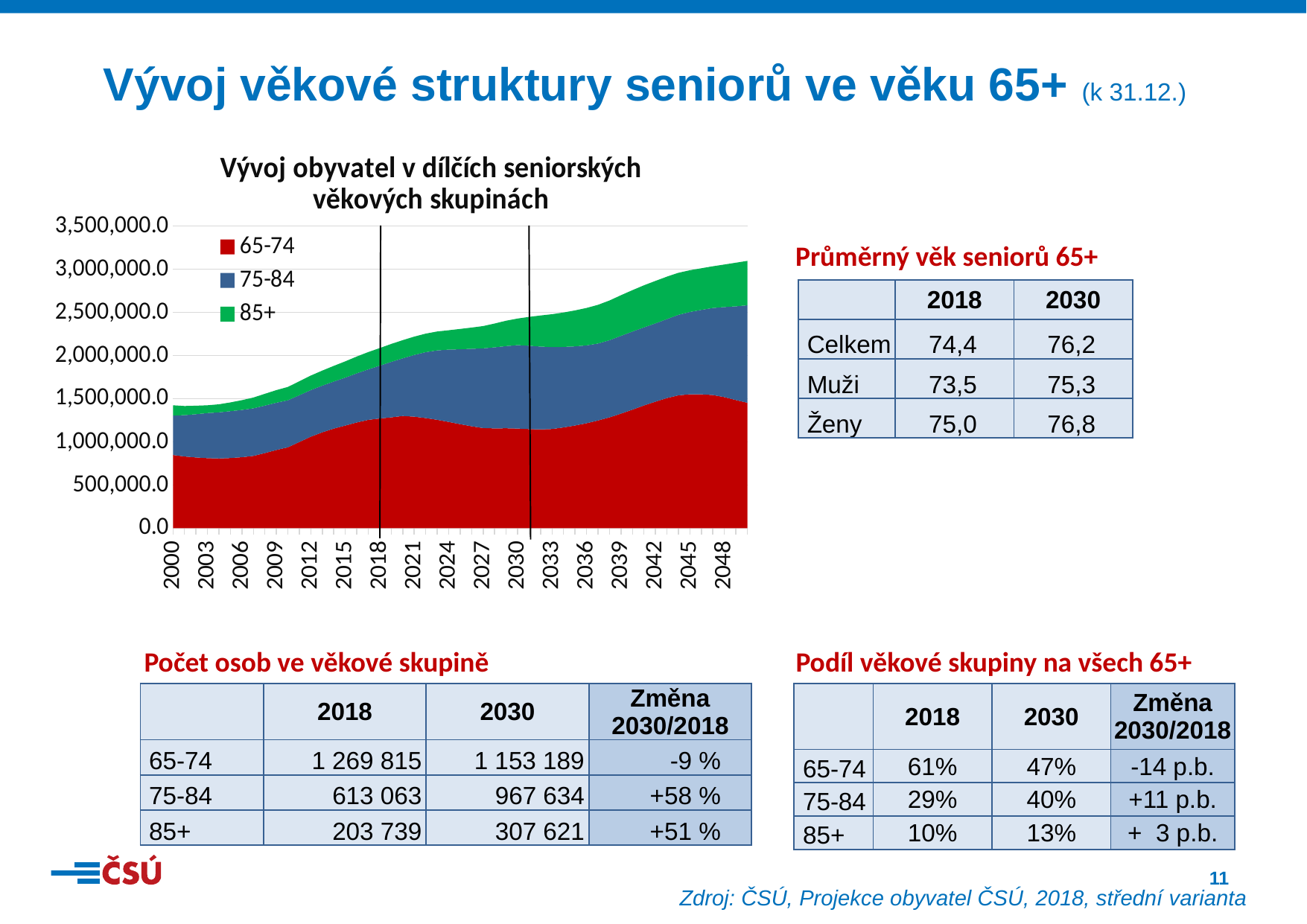
Is the total stacked value for 2018 greater or less than 1,500,000? greater Which colour represents the 85+ age group in the chart? green Does the total number of seniors 65+ in the chart rise or fall from 2000 to 2048? rise Is the value of the 65-74 series in 2000 greater or less than 1,000,000? less Is the total stacked value for 2000 greater or less than 1,500,000? less How many year labels are shown on the x axis of the chart? 17 How many series does the chart legend list? 3 Which series occupies the bottom layer of the stacked area chart? 65-74 What kind of chart is shown on the slide? stacked area chart What is the title of the chart? Vývoj obyvatel v dílčích seniorských věkových skupinách